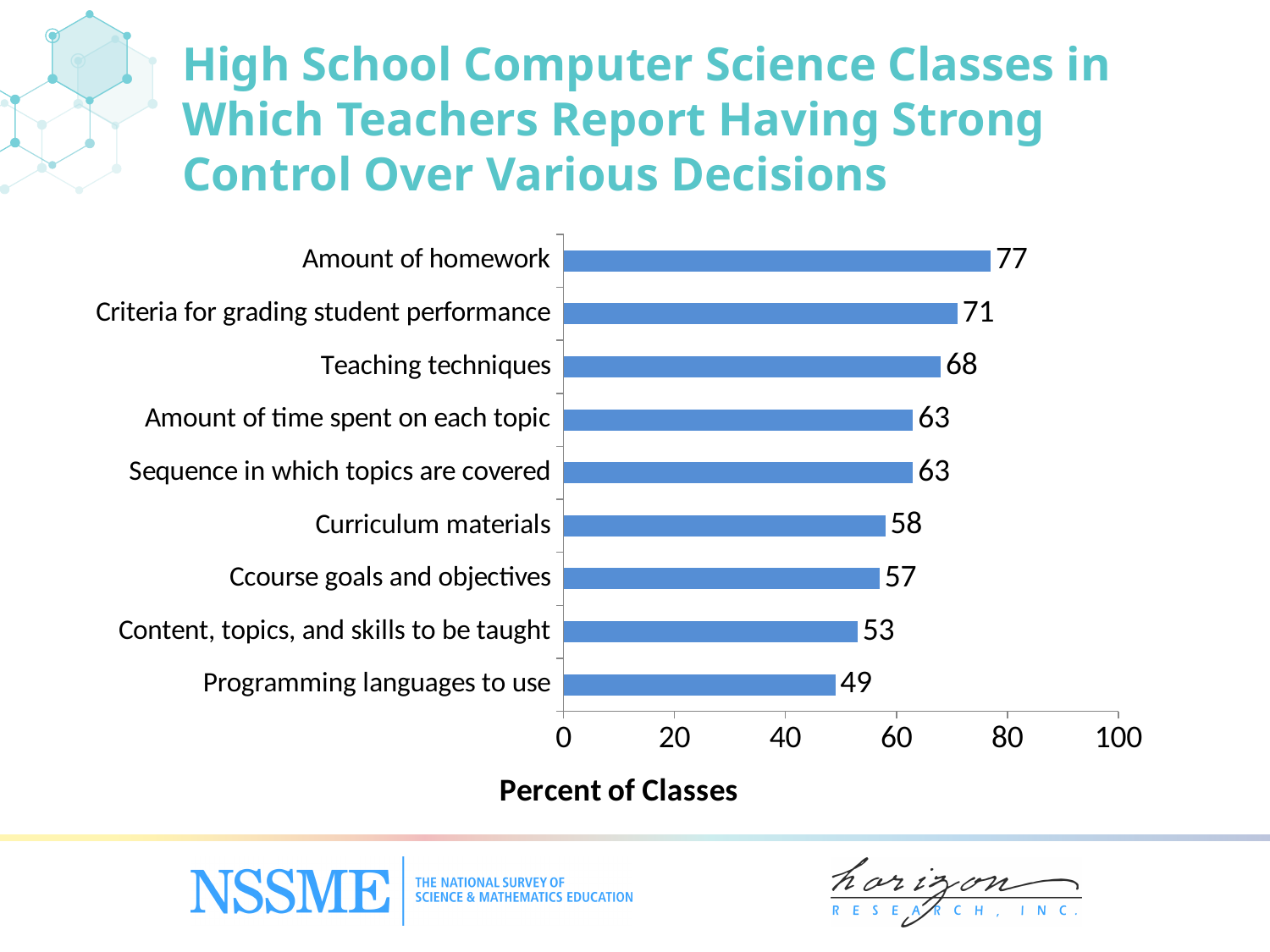
What kind of chart is shown on the slide? Bar chart What is the label of the horizontal axis? Percent of Classes What is the value for Programming languages to use? 49 What is the value for Teaching techniques? 68 Which category has the lowest percent of classes? Programming languages to use Is the value for Curriculum materials greater or less than 40? greater Which category has the highest percent of classes? Amount of homework What is the difference between the values for Amount of homework and Programming languages to use? 28 What is the difference between Criteria for grading student performance and Curriculum materials? 13 What percent of classes is shown for Amount of homework? 77 How many categories are shown in the chart? 9 Which is larger, the value for Teaching techniques or the value for Content, topics, and skills to be taught? Teaching techniques